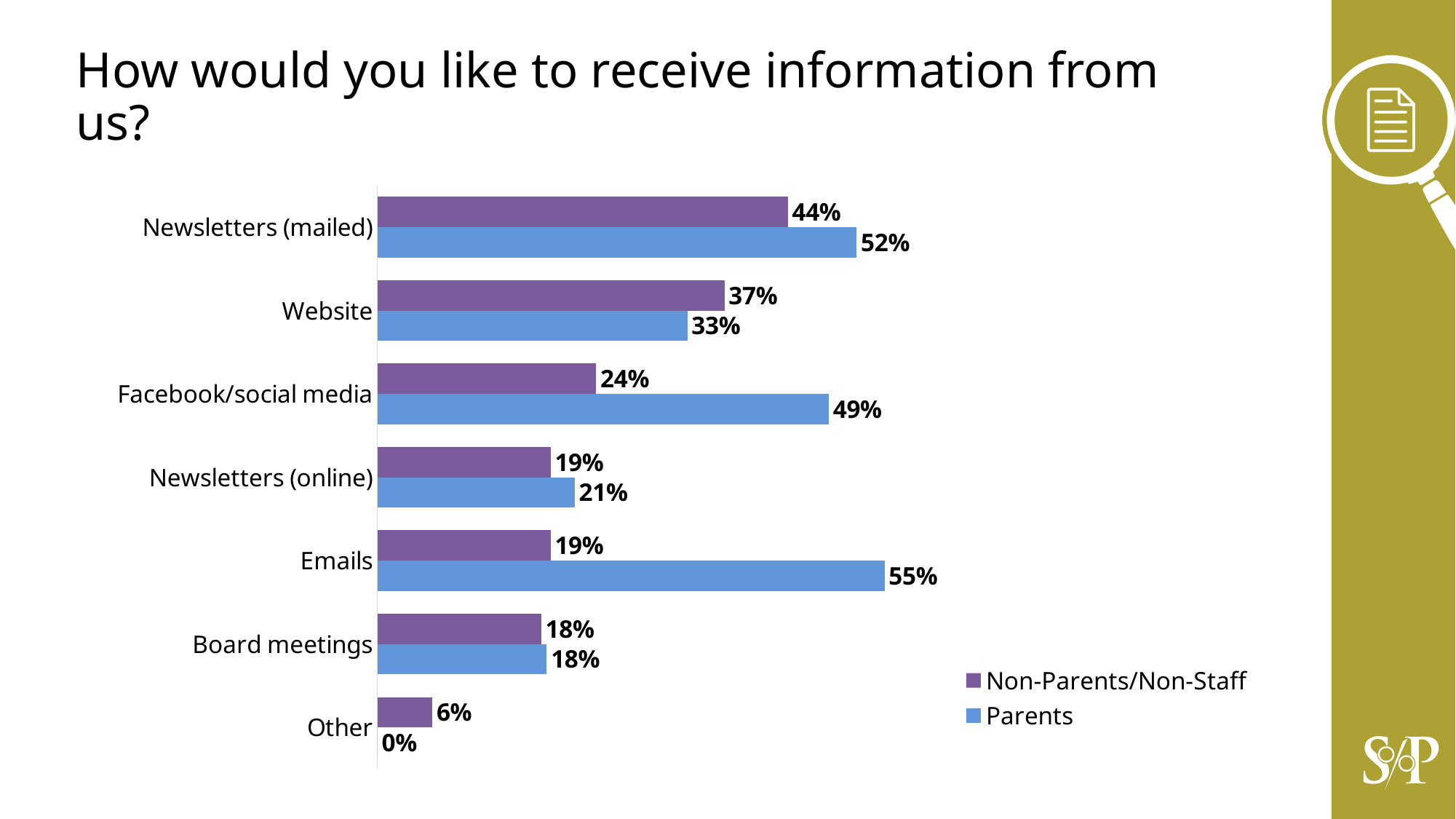
How many series does the legend list? 2 What is the difference between the Parents and Non-Parents/Non-Staff values for Emails? 36% Which category has the highest value for Parents? Emails How many categories are shown on the chart? 7 What percentage of Parents chose Emails? 55% For Website, which group has the larger value, Parents or Non-Parents/Non-Staff? Non-Parents/Non-Staff Which category has the lowest value for Non-Parents/Non-Staff? Other What kind of chart is shown on the slide? Bar chart What percentage of Parents chose Facebook/social media? 49% Which colour represents the Parents series? Blue What percentage of Non-Parents/Non-Staff chose Newsletters (mailed)? 44% What is the difference between the Parents and Non-Parents/Non-Staff values for Facebook/social media? 25%